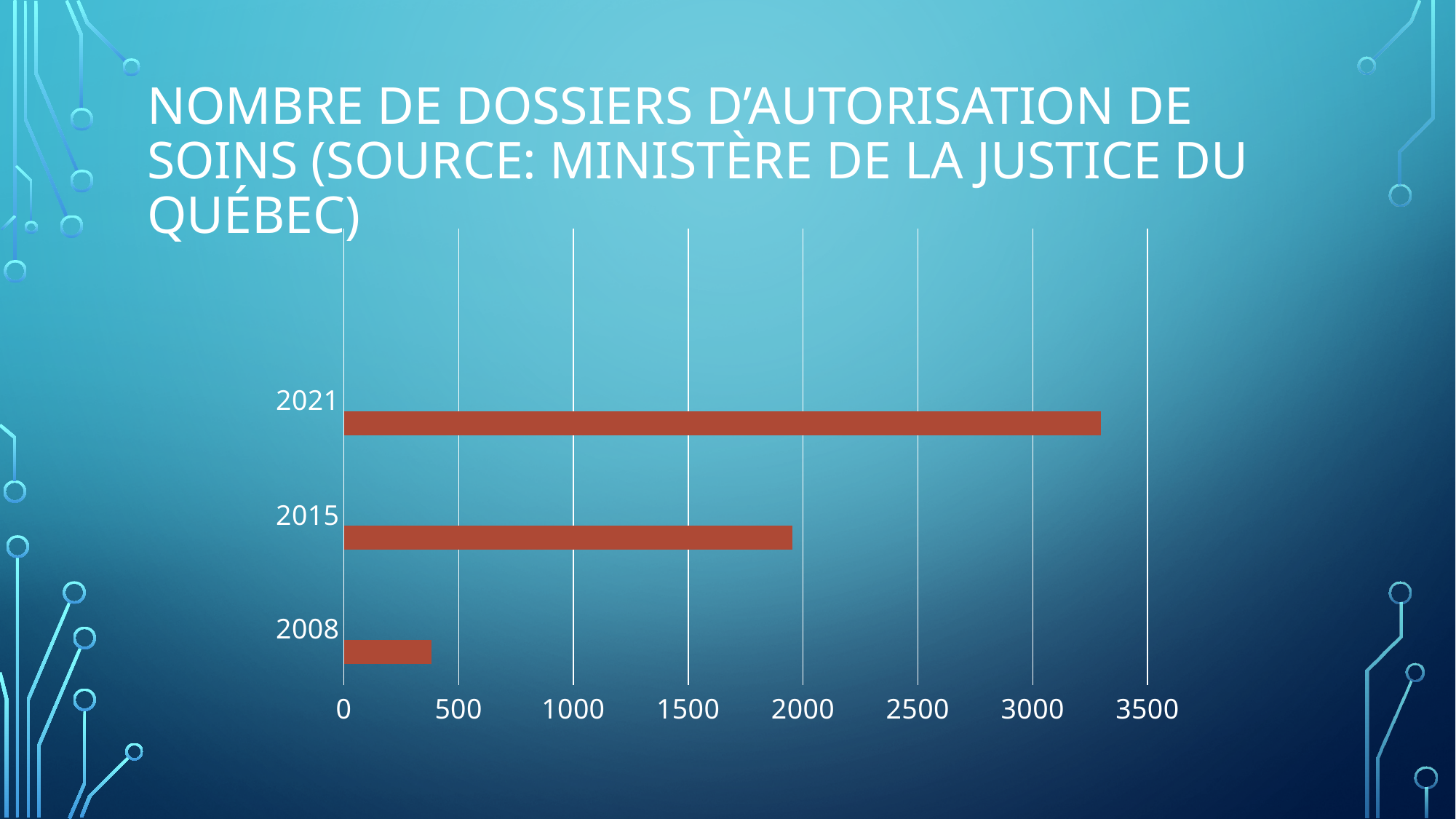
Is the value for 2021 greater or less than 3000? greater Which year has the highest number of dossiers d'autorisation de soins? 2021 What is the highest value shown on the horizontal axis? 3500 According to the chart title, what is the source of the data? Ministère de la Justice du Québec Is the value for 2015 greater or less than 1500? greater Do the values rise or fall from 2008 to 2021? rise Which year has the lowest number of dossiers d'autorisation de soins? 2008 What kind of chart is shown on the slide? bar chart How many years (categories) are shown in the chart? 3 Which is larger, the value for 2015 or the value for 2021? 2021 Is the value for 2021 greater or less than 3500? less